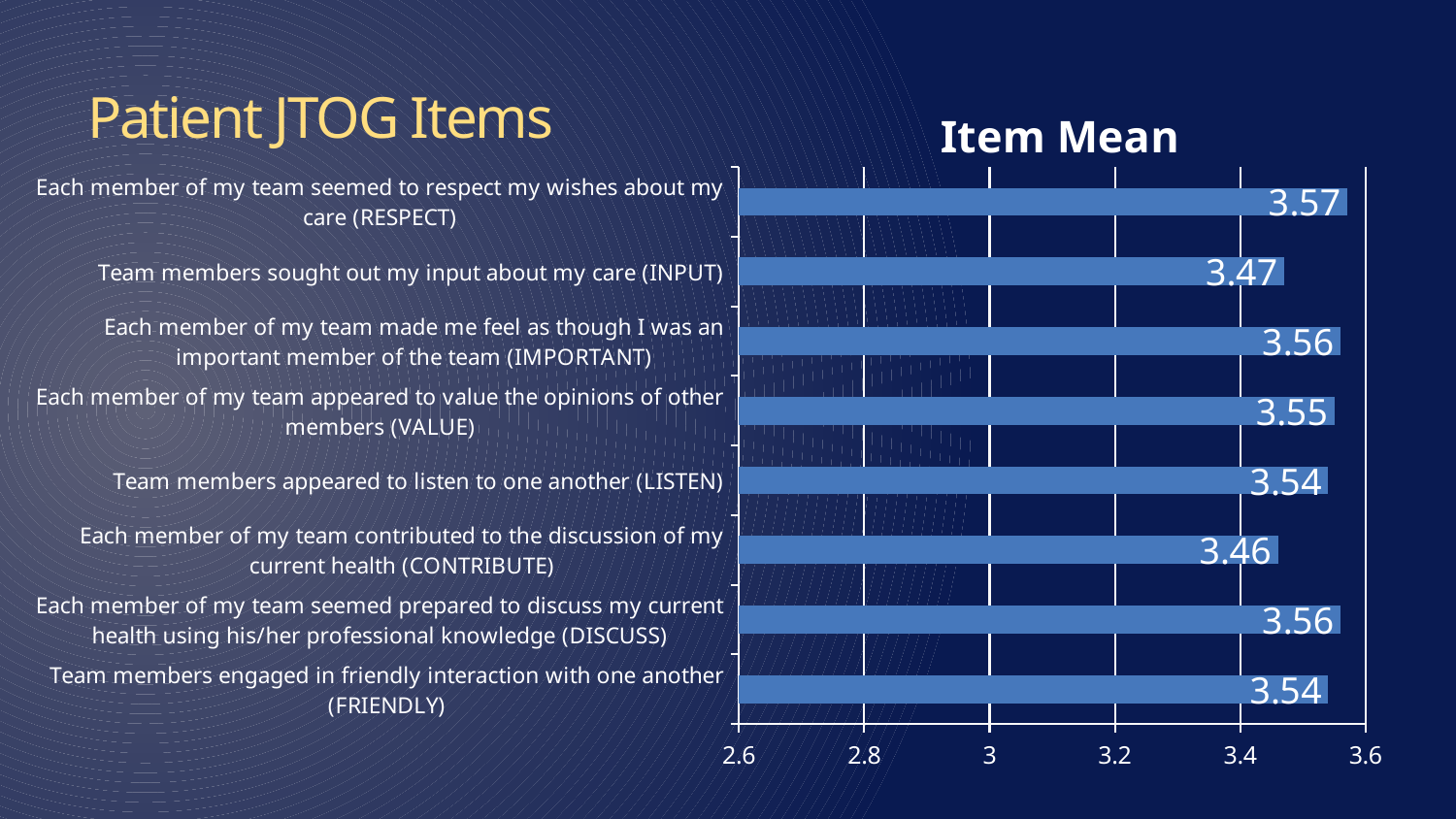
Which has a larger item mean, INPUT or VALUE? VALUE What is the item mean for the RESPECT item? 3.57 What is the item mean for the LISTEN item? 3.54 What kind of chart is shown on the slide? Bar chart How many items are plotted in the chart? 8 What is the difference between the item means for INPUT and CONTRIBUTE? 0.01 Which item has the highest item mean? RESPECT Is the item mean for FRIENDLY greater or less than 3.4? greater What is the title of the chart? Item Mean What is the difference between the item means for RESPECT and CONTRIBUTE? 0.11 What is the item mean for the CONTRIBUTE item? 3.46 Which item has the lowest item mean? CONTRIBUTE